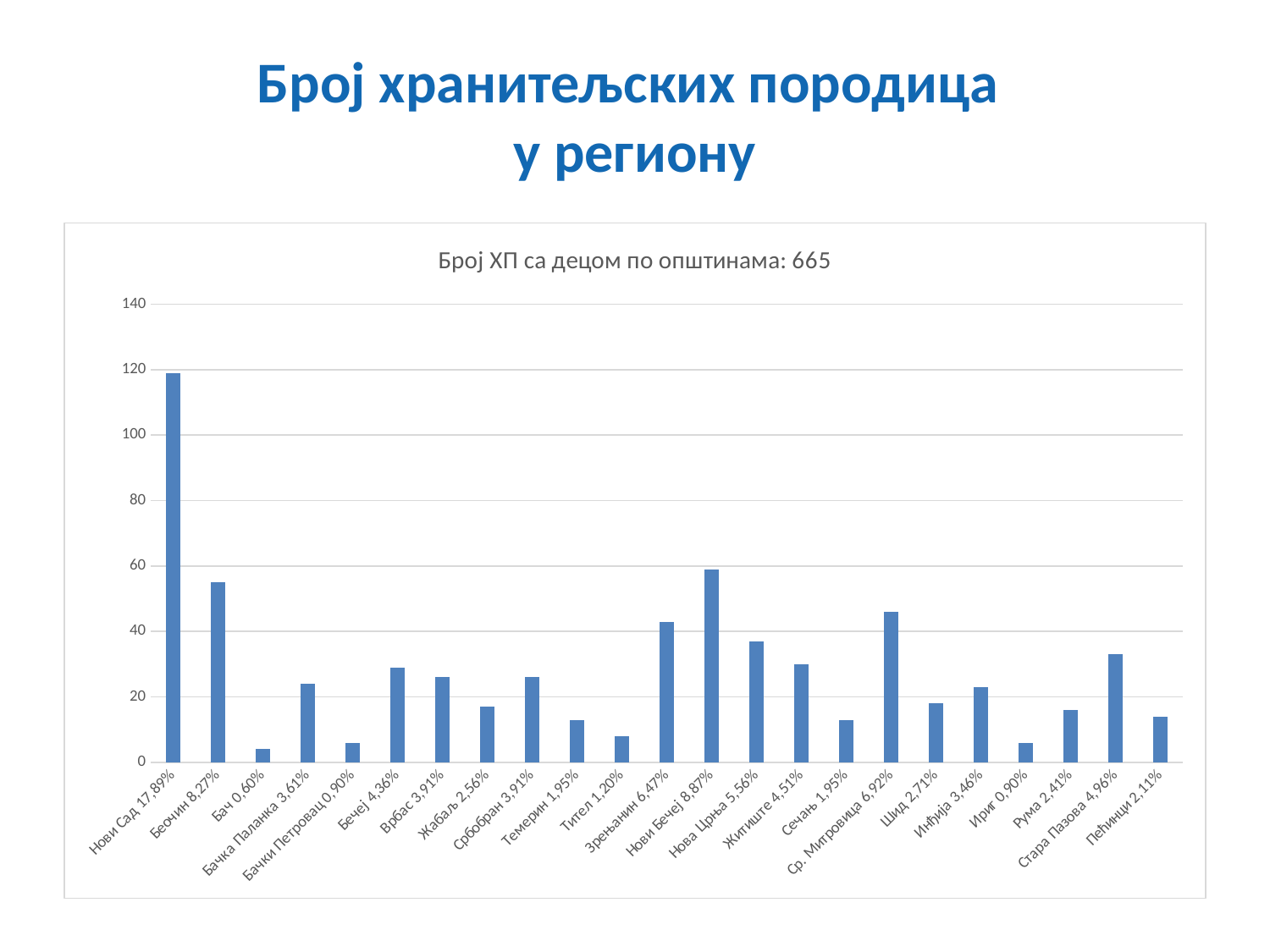
Is the value for Беочин greater or less than 60? less Which municipality has the highest bar? Нови Сад Is the value for Стара Пазова greater or less than 40? less Is the value for Нови Сад greater or less than 100? greater What kind of chart is shown on the slide? bar chart What percentage is shown in the axis label for Нови Сад? 17,89% Which has the larger bar, Беочин or Зрењанин? Беочин What is the title of the chart? Број ХП са децом по општинама: 665 Which municipality has the lowest bar? Бач Which has the larger bar, Нови Бечеј or Ср. Митровица? Нови Бечеј How many municipalities (categories) are shown on the x axis? 23